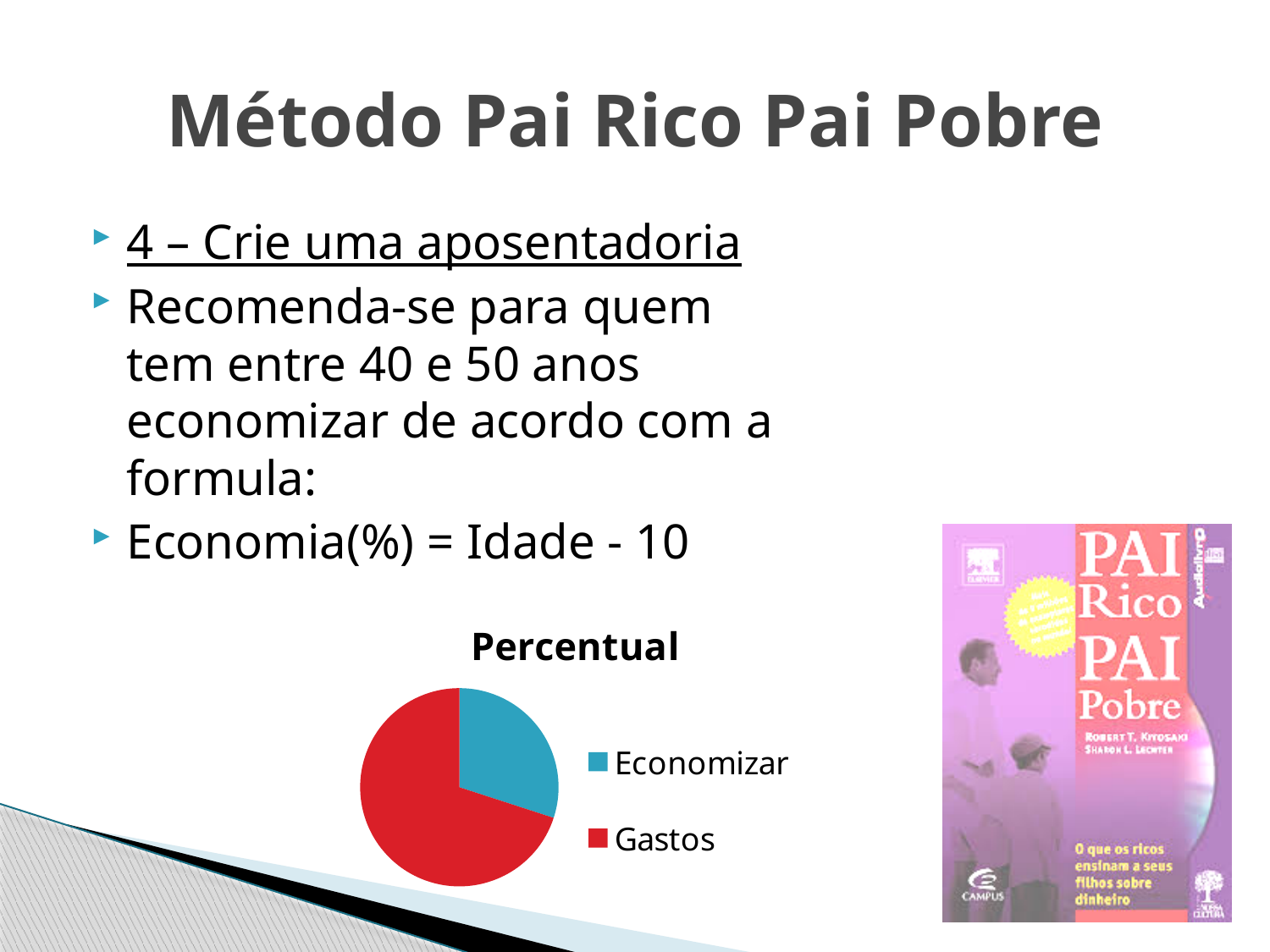
How many slices does the pie chart have? 2 What kind of chart is shown on the slide? pie chart Which legend entry is shown in blue? Economizar Which slice of the pie chart is the smallest? Economizar How many entries does the chart's legend list? 2 Which is larger in the pie chart, Economizar or Gastos? Gastos What is the title of the chart? Percentual What colour is the Gastos slice in the pie chart? red Which slice of the pie chart is the largest? Gastos